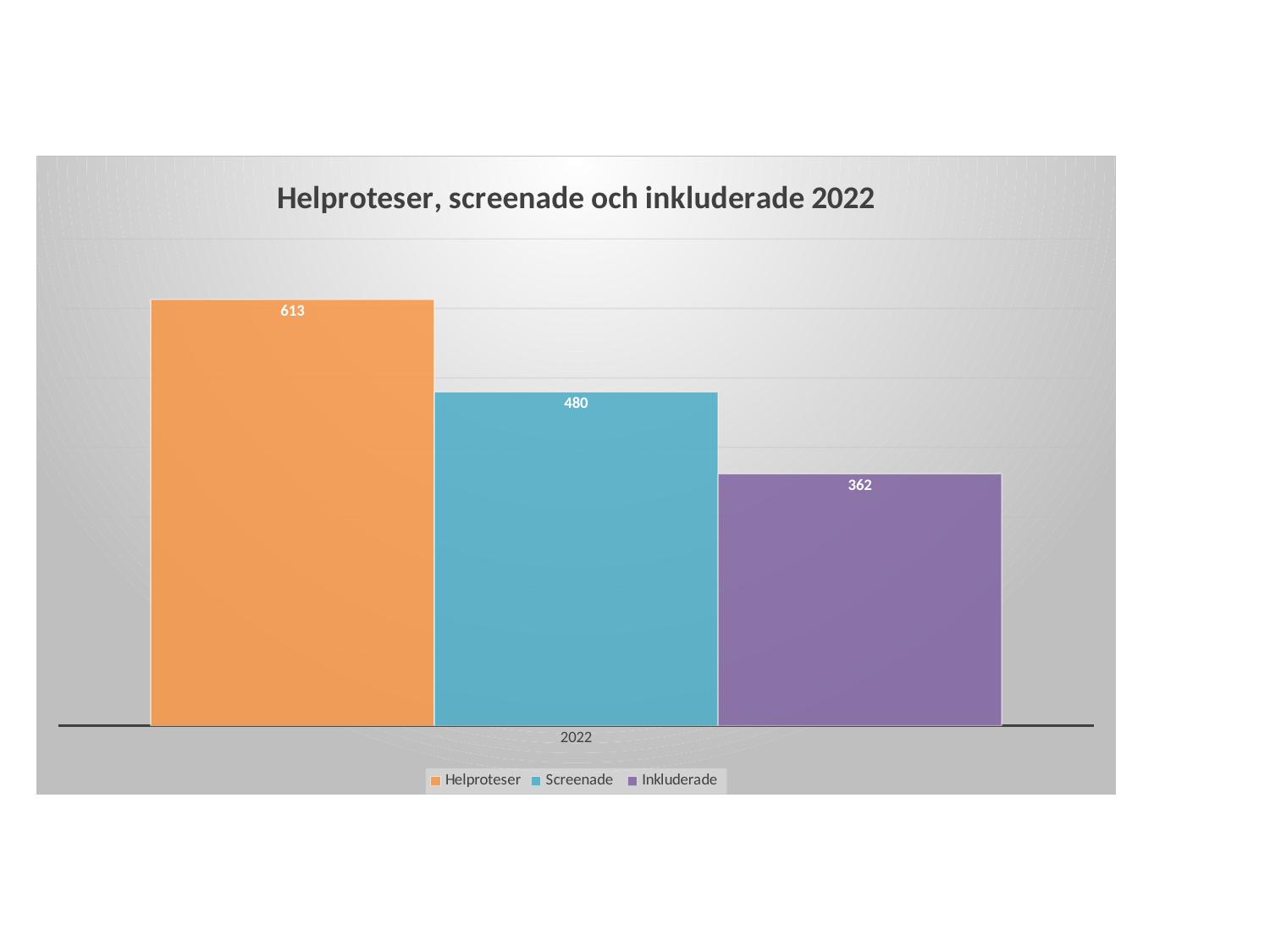
What is the difference between Helproteser and Screenade? 133 Which series has the lowest value? Inkluderade What is the difference between Screenade and Inkluderade? 118 What colour is the Inkluderade bar? Purple What kind of chart is shown? Bar chart What is the title of the chart? Helproteser, screenade och inkluderade 2022 What is the value for Inkluderade in 2022? 362 What is the value for Screenade in 2022? 480 How many series does the legend list? 3 Which is larger, Screenade or Inkluderade? Screenade Which series has the highest value? Helproteser What is the value for Helproteser in 2022? 613